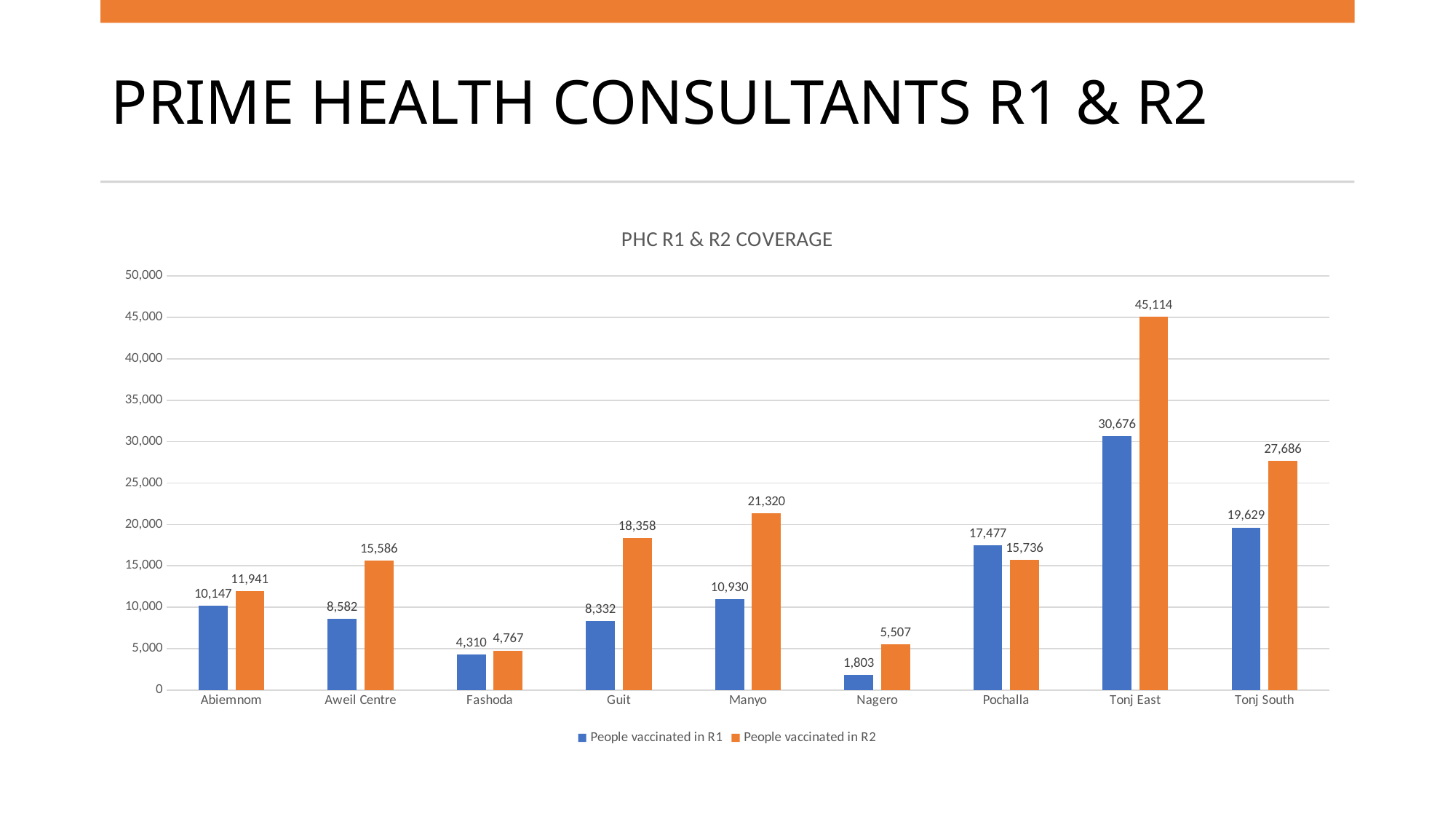
How many series does the legend list? 2 What is the difference between people vaccinated in R2 and R1 in Tonj East? 14,438 Which county has the highest number of people vaccinated in R2? Tonj East How many counties are shown on the x axis of the chart? 9 Is the value for people vaccinated in R2 in Manyo greater or less than 20,000? greater In Pochalla, which is larger: people vaccinated in R1 or people vaccinated in R2? People vaccinated in R1 What kind of chart is shown on the slide? Bar chart How many people were vaccinated in R1 in Guit? 8,332 What colour are the bars for people vaccinated in R2? Orange Which county has the lowest number of people vaccinated in R1? Nagero How many people were vaccinated in R2 in Tonj South? 27,686 What is the title of the chart? PHC R1 & R2 COVERAGE